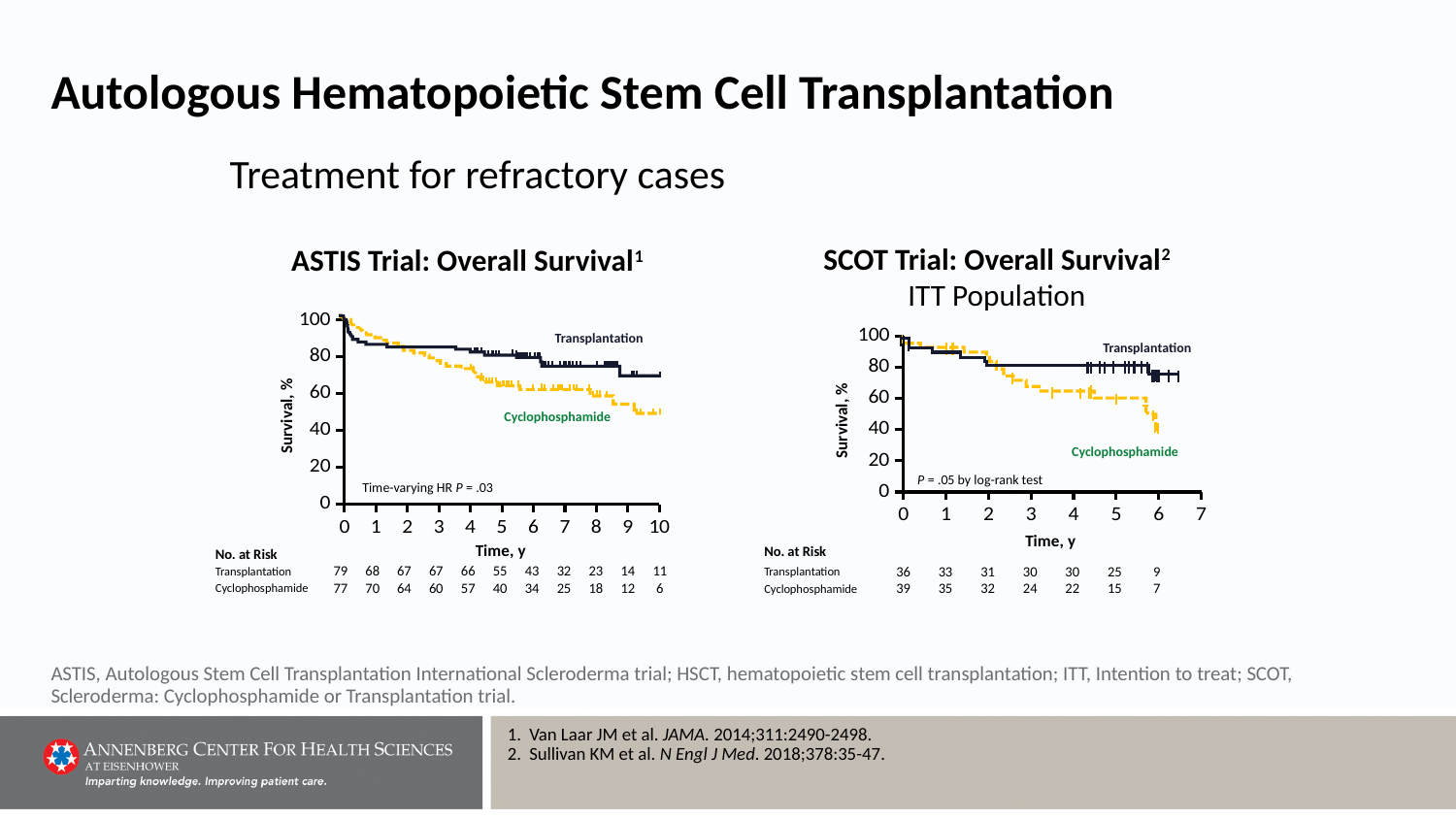
How many survival curves are plotted in the SCOT Trial: Overall Survival chart? 2 In the ASTIS Trial: Overall Survival chart, how many patients in the Transplantation group were at risk at year 0? 79 In the SCOT Trial: Overall Survival chart, how many patients in the Cyclophosphamide group were at risk at year 3? 24 In the ASTIS Trial: Overall Survival chart, which group has the higher survival at year 8, Transplantation or Cyclophosphamide? Transplantation In the SCOT Trial: Overall Survival chart, does the Cyclophosphamide survival curve rise or fall as time increases? fall In the SCOT Trial: Overall Survival chart, is the Cyclophosphamide survival curve at year 6 greater or less than 60%? less In the ASTIS Trial: Overall Survival chart, how many patients in the Cyclophosphamide group were at risk at year 10? 6 In the ASTIS Trial: Overall Survival chart, is the Transplantation survival curve at year 10 greater or less than 60%? greater In the SCOT Trial: Overall Survival chart, how many patients in the Transplantation group were at risk at year 6? 9 What kind of chart is the ASTIS Trial: Overall Survival chart? line chart In the SCOT Trial: Overall Survival chart, what is the difference between the number at risk in the Cyclophosphamide group and the Transplantation group at year 0? 3 What P value is printed on the SCOT Trial: Overall Survival chart? P = .05 by log-rank test